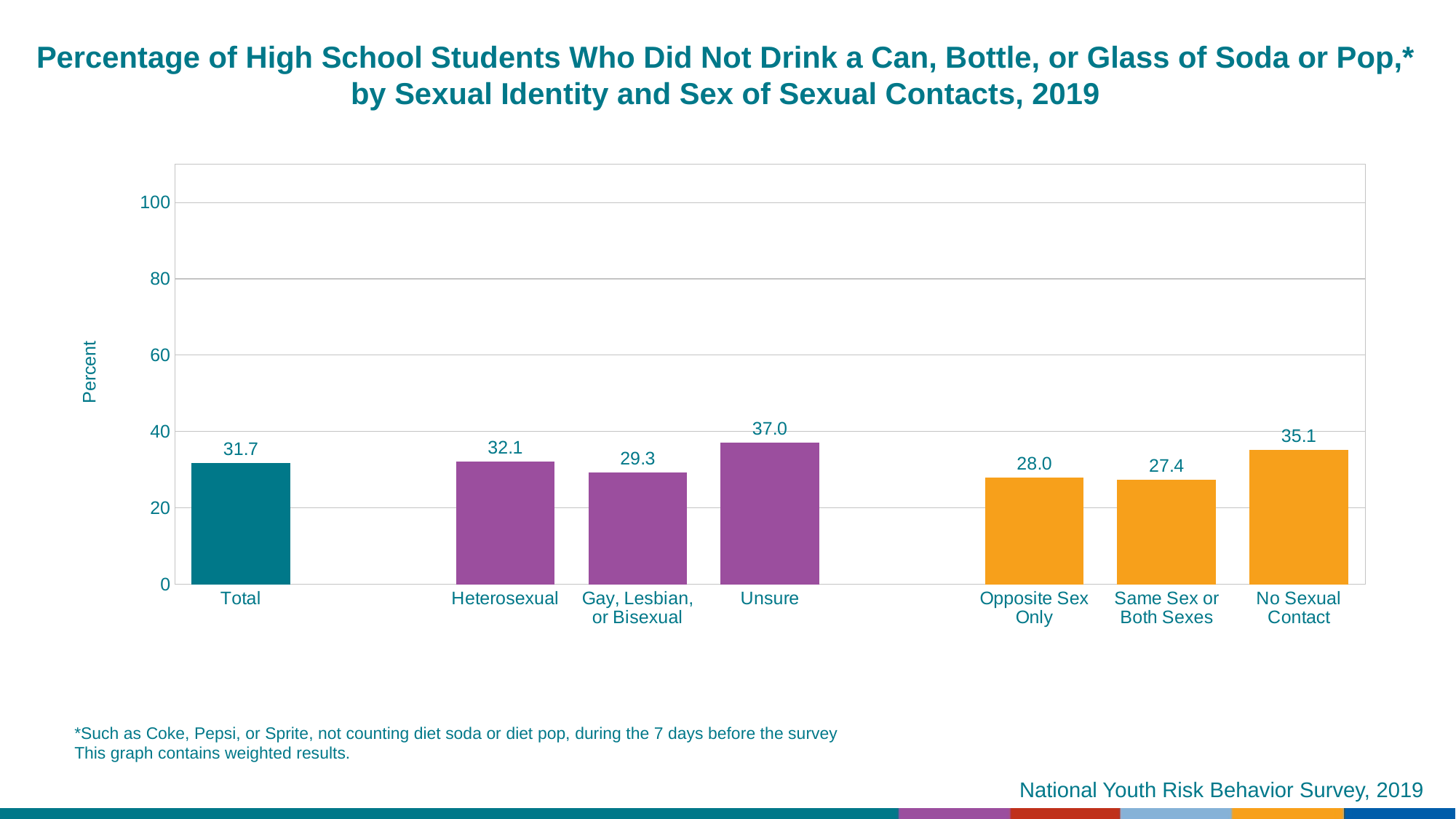
Which category has the lowest value? Same Sex or Both Sexes What is the value for Total? 31.7 Is the value for No Sexual Contact greater or less than 40? less How many categories are shown in the chart? 7 Which is larger, the value for Gay, Lesbian, or Bisexual or the value for Opposite Sex Only? Gay, Lesbian, or Bisexual What kind of chart is shown on the slide? bar chart What is the difference between the values for Unsure and Heterosexual? 4.9 What is the value for Unsure? 37.0 Which category has the highest value? Unsure What is the value for Same Sex or Both Sexes? 27.4 What is the label of the y axis? Percent What is the value for No Sexual Contact? 35.1